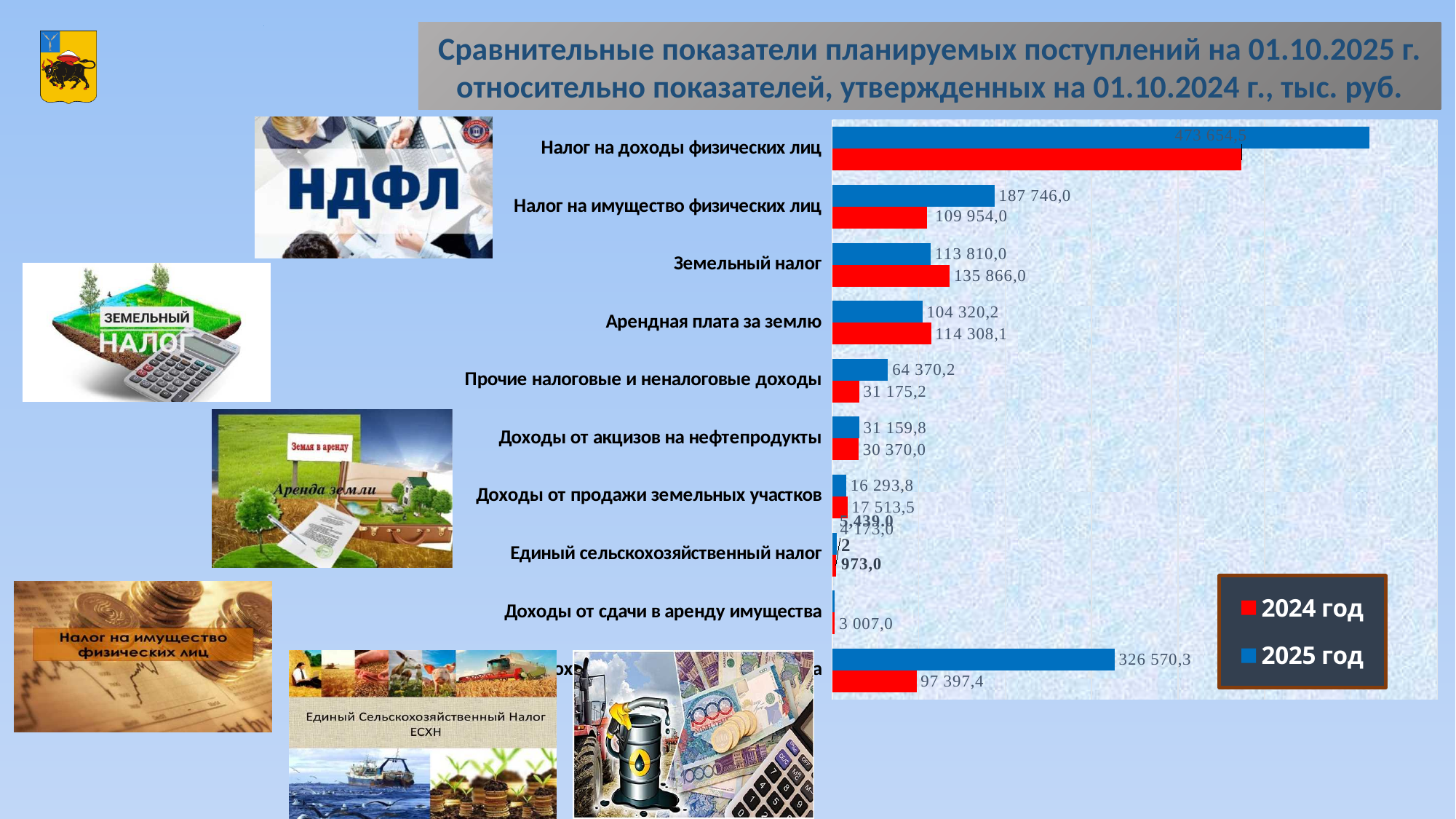
Which category has the highest 2025 год value? Налог на доходы физических лиц Which is larger for Земельный налог: the 2024 год value or the 2025 год value? 2024 год What is the 2025 год value for Налог на имущество физических лиц? 187 746,0 What colour are the bars for the 2024 год series? red What is the difference between the 2025 год and 2024 год values for Налог на имущество физических лиц? 77 792,0 What is the 2024 год value for Земельный налог? 135 866,0 What is the 2024 год value for Прочие налоговые и неналоговые доходы? 31 175,2 How many series does the legend list? 2 What kind of chart is shown on the slide? bar chart What is the 2025 год value for Арендная плата за землю? 104 320,2 Which two series are listed in the legend? 2024 год and 2025 год What is the 2024 год value for Доходы от продажи земельных участков? 17 513,5